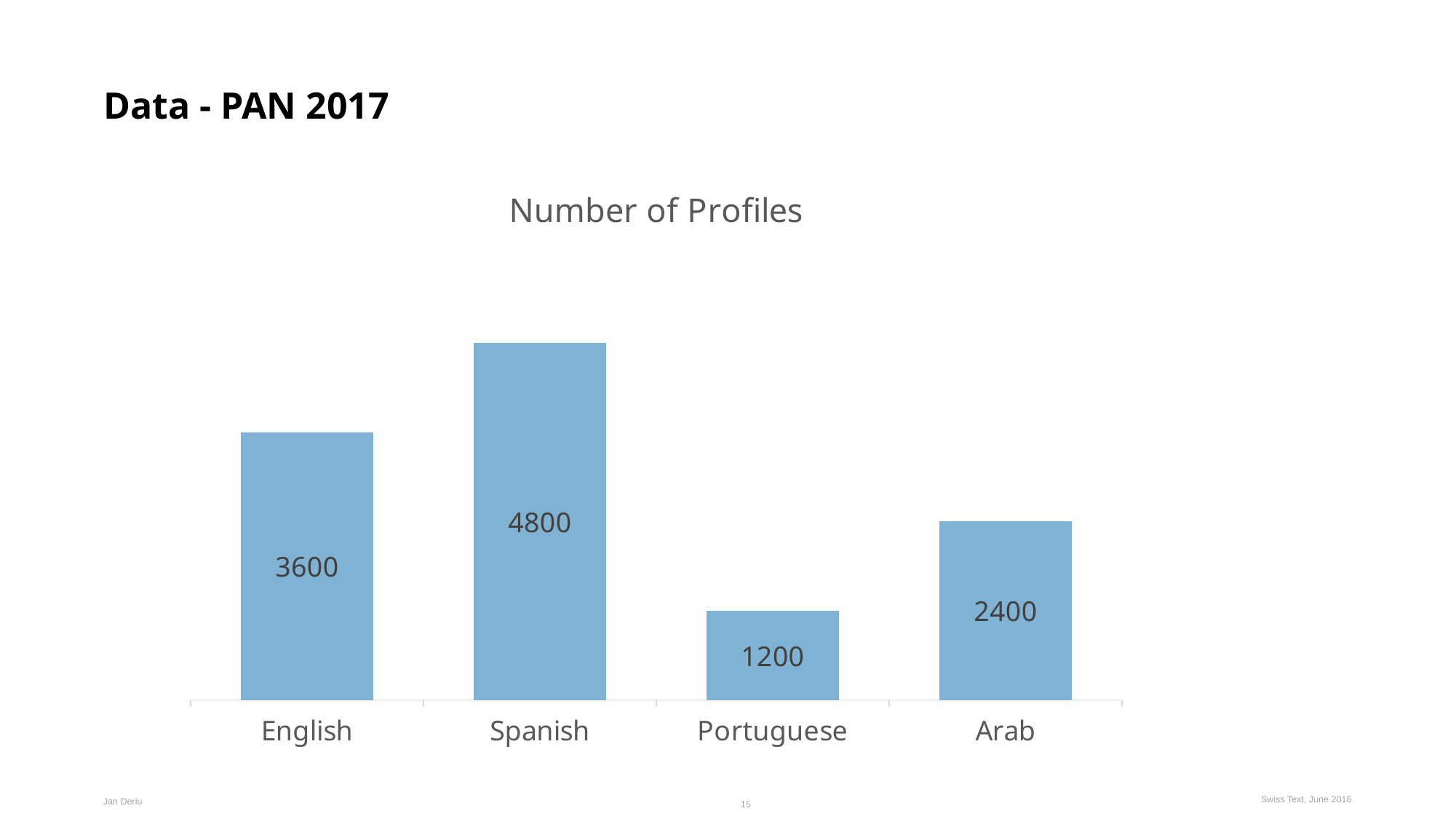
What is the difference between the number of profiles for Arab and Portuguese? 1200 What is the title of the chart? Number of Profiles What is the number of profiles for Portuguese? 1200 What is the number of profiles for Spanish? 4800 Which has more profiles, English or Arab? English Which language has the highest number of profiles? Spanish What is the number of profiles for Arab? 2400 Which language has the lowest number of profiles? Portuguese How many languages are shown in the chart? 4 What is the difference between the number of profiles for Spanish and English? 1200 What is the number of profiles for English? 3600 What kind of chart is shown on the slide? Bar chart